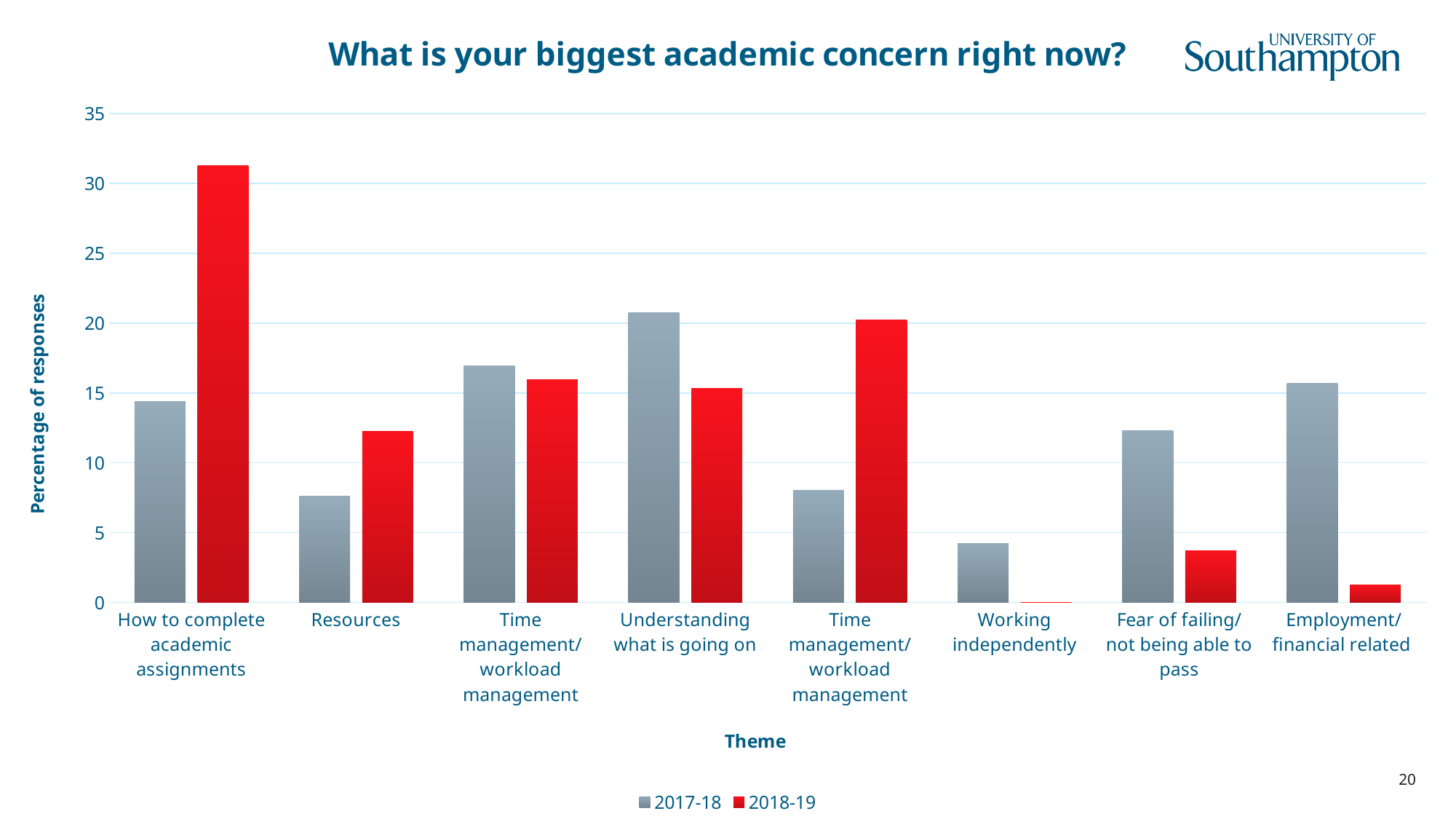
Is the 2018-19 value for Fear of failing/not being able to pass greater or less than 5? less Which theme has the lowest value for 2017-18? Working independently What kind of chart is shown on the slide? bar chart Is the 2017-18 value for Resources greater or less than 10? less Which theme has the lowest value for 2018-19? Working independently What is the label of the y axis? Percentage of responses How many series does the legend list? 2 Is the 2018-19 value for How to complete academic assignments greater or less than 30? greater Which theme has the highest value for 2018-19? How to complete academic assignments How many theme categories are shown on the x axis? 8 Which theme has the highest value for 2017-18? Understanding what is going on For Employment/financial related, which series has the larger value, 2017-18 or 2018-19? 2017-18